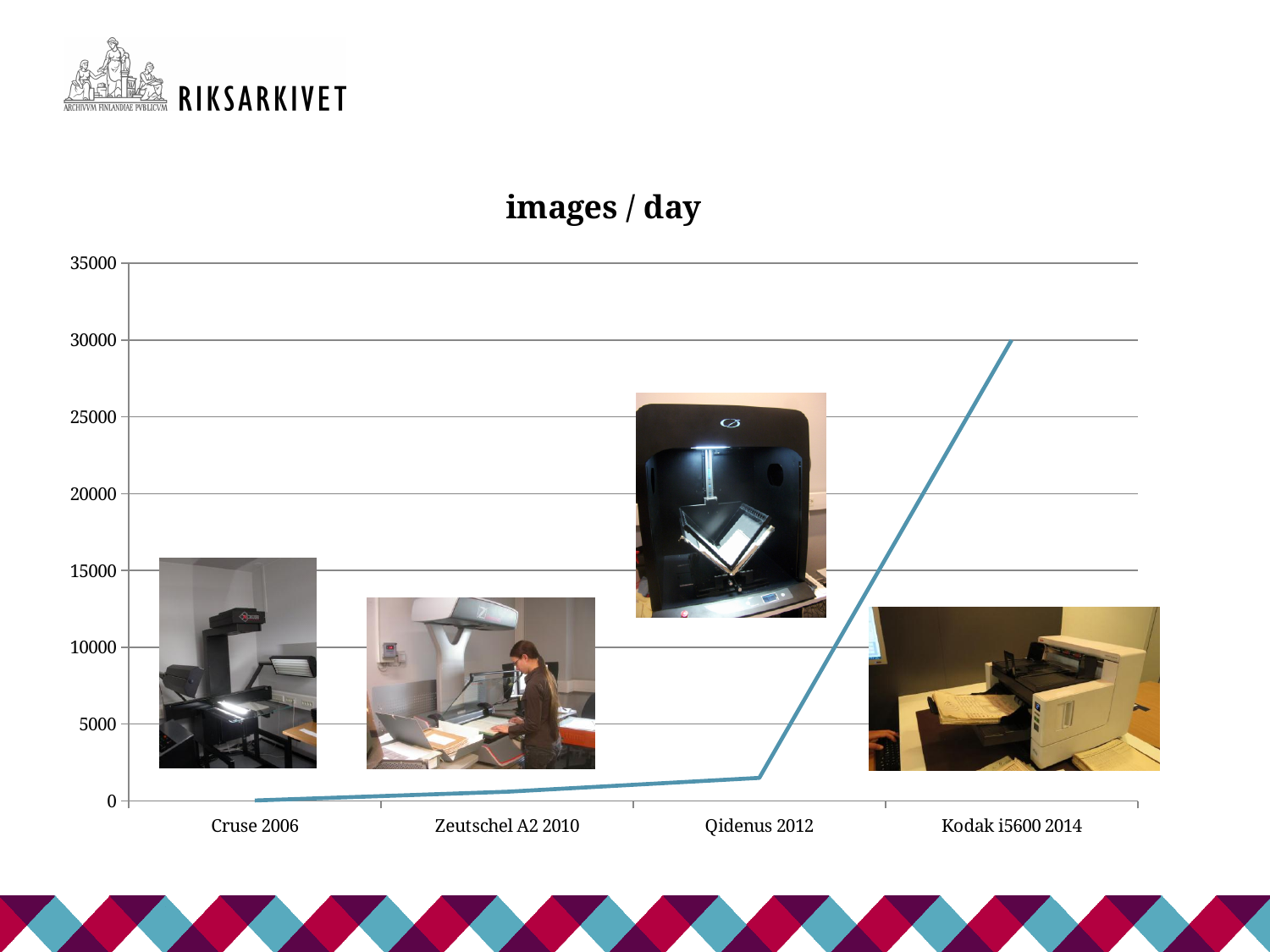
Which category has the highest value in the chart? Kodak i5600 2014 Is the value for Zeutschel A2 2010 greater or less than 5000? less Which has a larger value, Qidenus 2012 or Kodak i5600 2014? Kodak i5600 2014 How many categories are shown on the x axis of the chart? 4 What is the highest value shown on the y axis of the chart? 35000 What is the title of the chart? images / day What type of chart is shown on the slide? line chart Which category has the lowest value in the chart? Cruse 2006 What is the value for Kodak i5600 2014? 30000 Is the value for Kodak i5600 2014 greater or less than 25000? greater Do the values rise or fall from Cruse 2006 to Kodak i5600 2014? rise Is the value for Qidenus 2012 greater or less than 5000? less